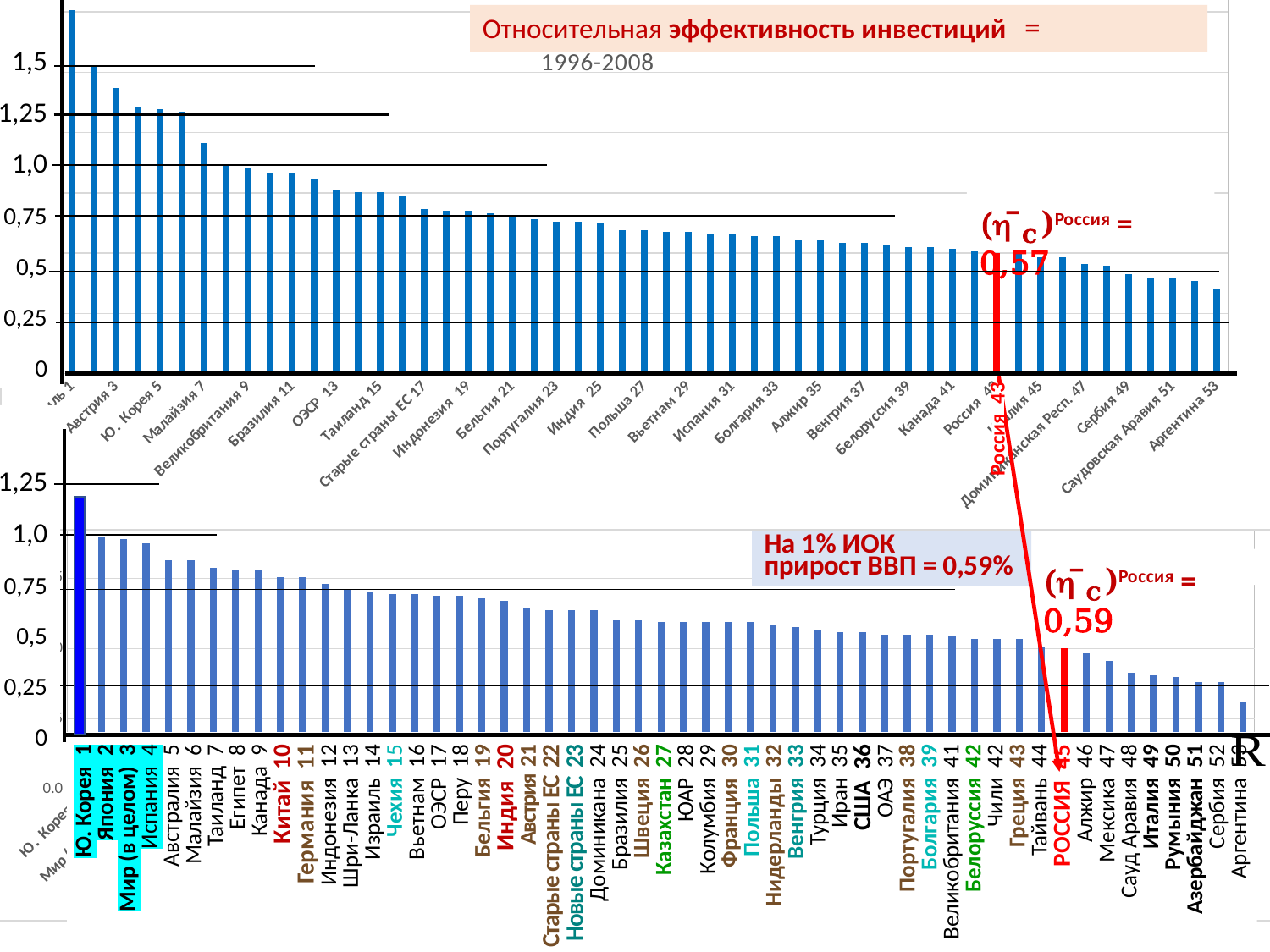
In the bottom chart, which category has the lowest value? Аргентина In the bottom chart, which has the larger value: Китай 10 or Индия 20? Китай 10 In the top chart, do the values rise or fall from left to right along the x axis? Fall In the top chart, is the value for Малайзия 7 greater or less than 1,0? greater In the bottom chart, is the value for Мексика 47 greater or less than 0,5? less In the top chart (Относительная эффективность инвестиций), what value is given for Россия? 0,57 In the bottom chart, which category has the highest value? Ю. Корея In the bottom chart, what value is given for РОССИЯ? 0,59 In the bottom chart, is the value for Ю. Корея greater or less than 1,25? less In the top chart, which category has the lowest value? Аргентина 53 What kind of chart is the top chart on the slide? Bar chart